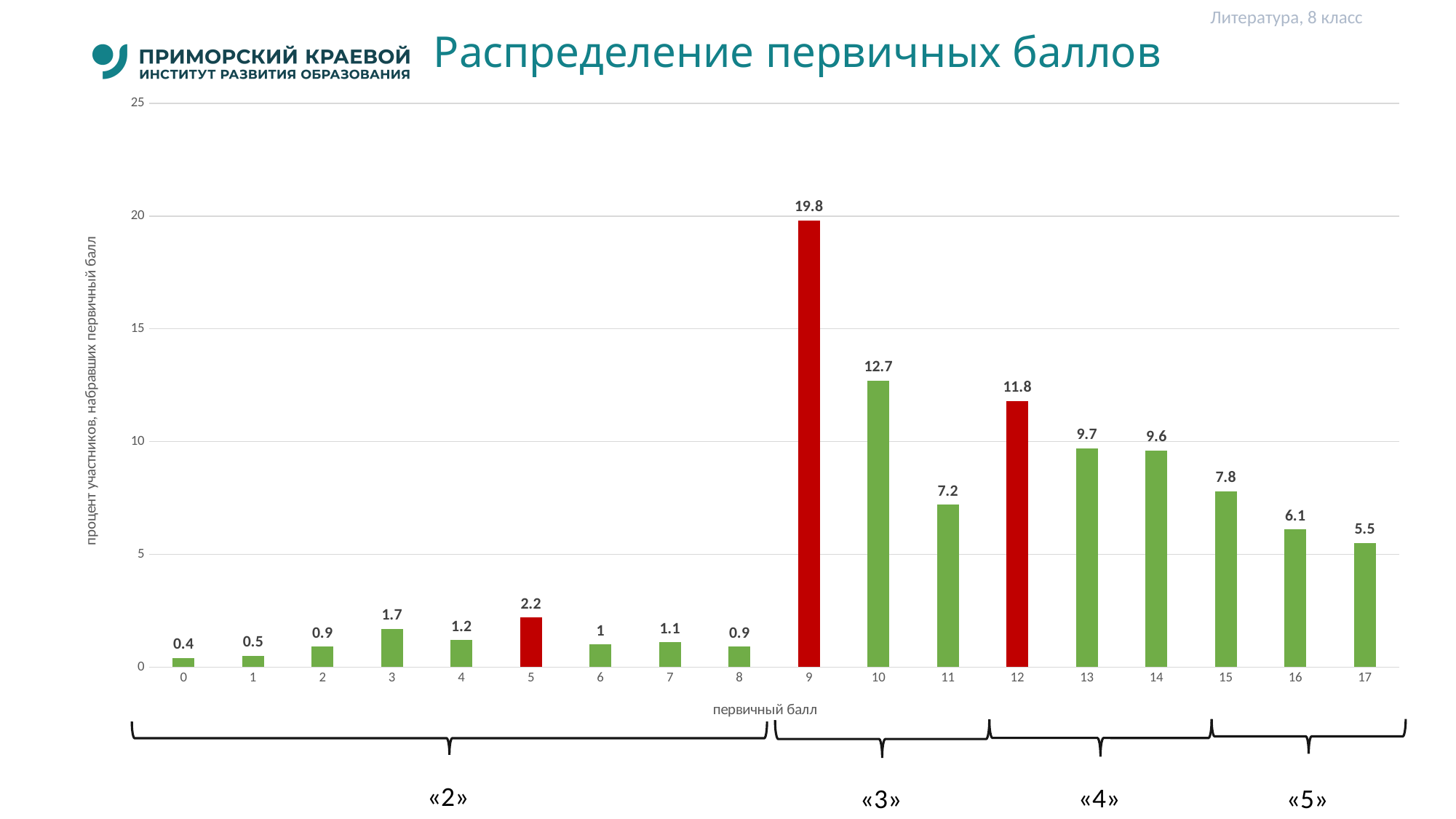
Which is larger, the value for primary score 13 or primary score 15? 13 What is the value for primary score 9? 19.8 Which primary scores are shown with red bars? 5, 9 and 12 What is the value for primary score 3? 1.7 How many primary score categories are shown on the x axis? 18 What kind of chart is shown on the slide? bar chart Is the value for primary score 10 greater or less than 10? greater Do the values rise or fall from primary score 12 to primary score 17? fall Which primary score has the highest percentage of participants? 9 Which primary score has the lowest percentage of participants? 0 What is the difference between the values for primary scores 10 and 11? 5.5 What is the value for primary score 12? 11.8